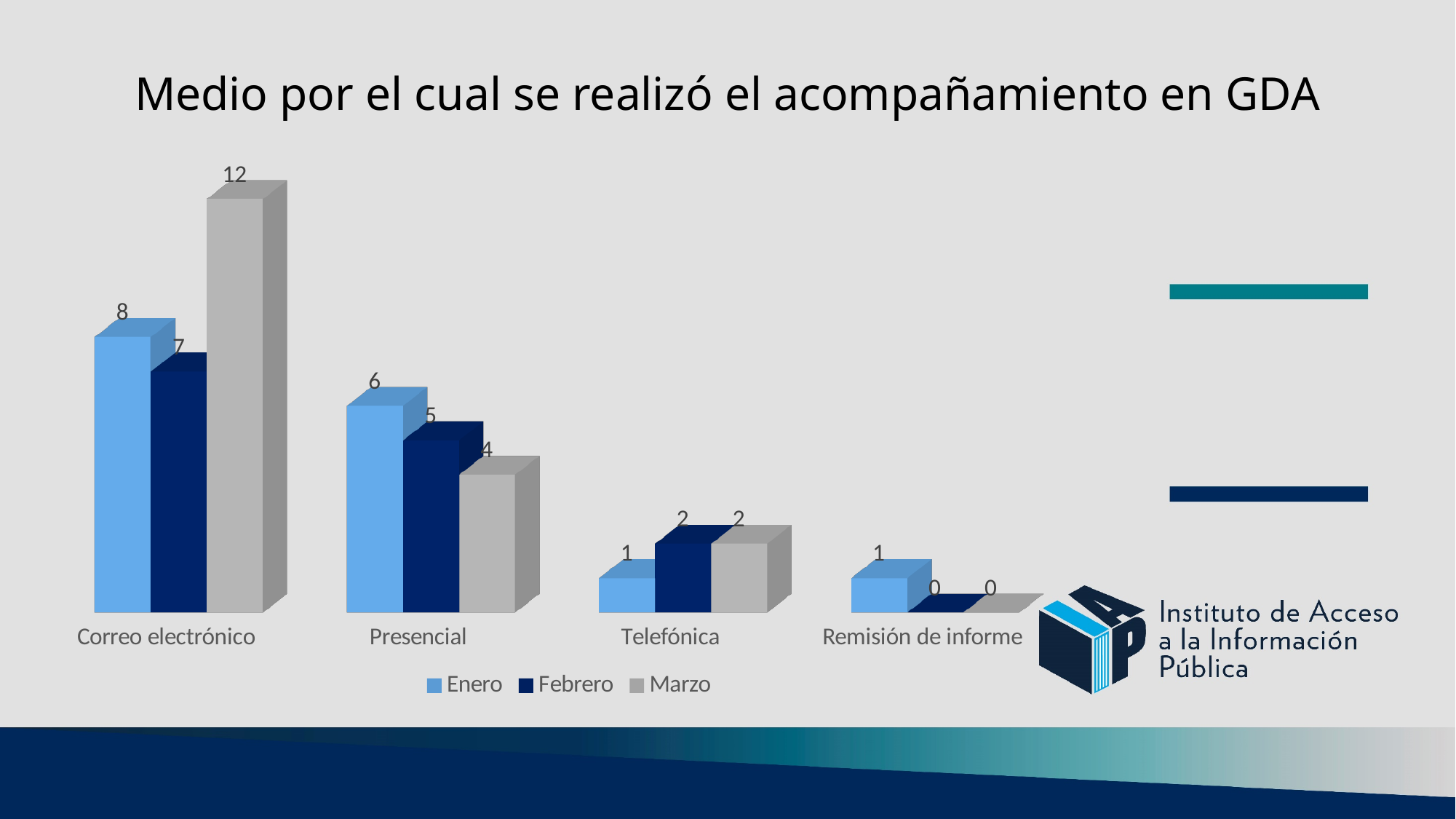
How many series does the legend list? 3 What is the value for Marzo in the Correo electrónico category? 12 What is the value for Febrero in the Presencial category? 5 Which category has the highest value for Marzo? Correo electrónico What kind of chart is shown on the slide? Bar chart Which category has the lowest value for Enero? Telefónica and Remisión de informe (both 1) What is the difference between the Marzo and Enero values for Correo electrónico? 4 What is the title of the chart? Medio por el cual se realizó el acompañamiento en GDA What is the value for Marzo in the Remisión de informe category? 0 How many categories are shown on the x axis? 4 What is the value for Enero in the Telefónica category? 1 Which is larger for Presencial: the Enero value or the Marzo value? Enero